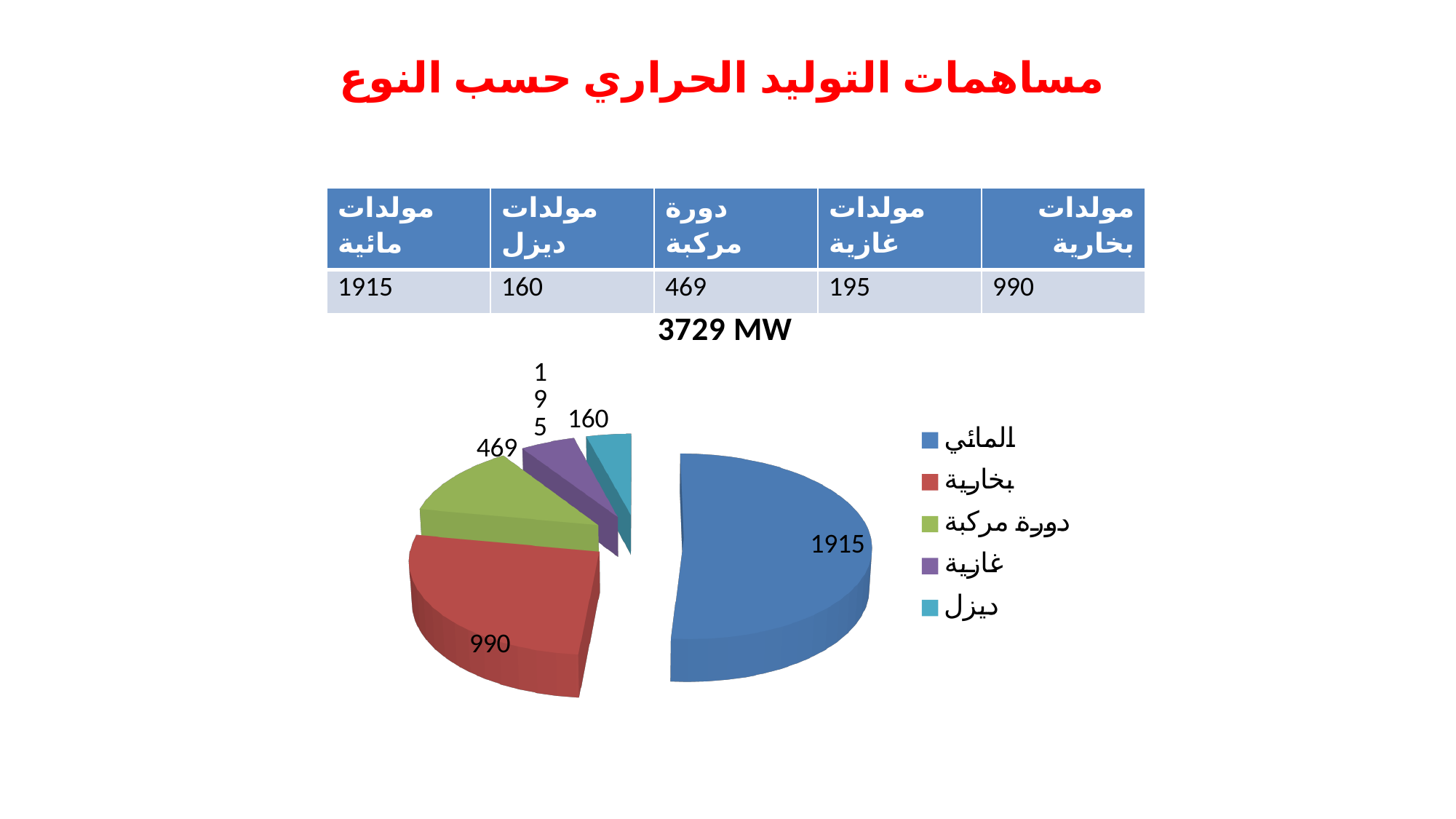
Which category has the largest slice in the pie chart? المائي Which category has the smallest slice in the pie chart? ديزل What value is shown for the بخارية slice of the pie chart? 990 What value is shown for the المائي slice of the pie chart? 1915 How many slices does the pie chart have? 5 What value is shown for the دورة مركبة slice of the pie chart? 469 What kind of chart is shown on the slide? pie chart What is the difference between the المائي value and the بخارية value in the pie chart? 925 Which is larger in the pie chart, غازية or ديزل? غازية What value is shown for the غازية slice of the pie chart? 195 What value is shown for the ديزل slice of the pie chart? 160 What is the difference between the دورة مركبة value and the غازية value in the pie chart? 274